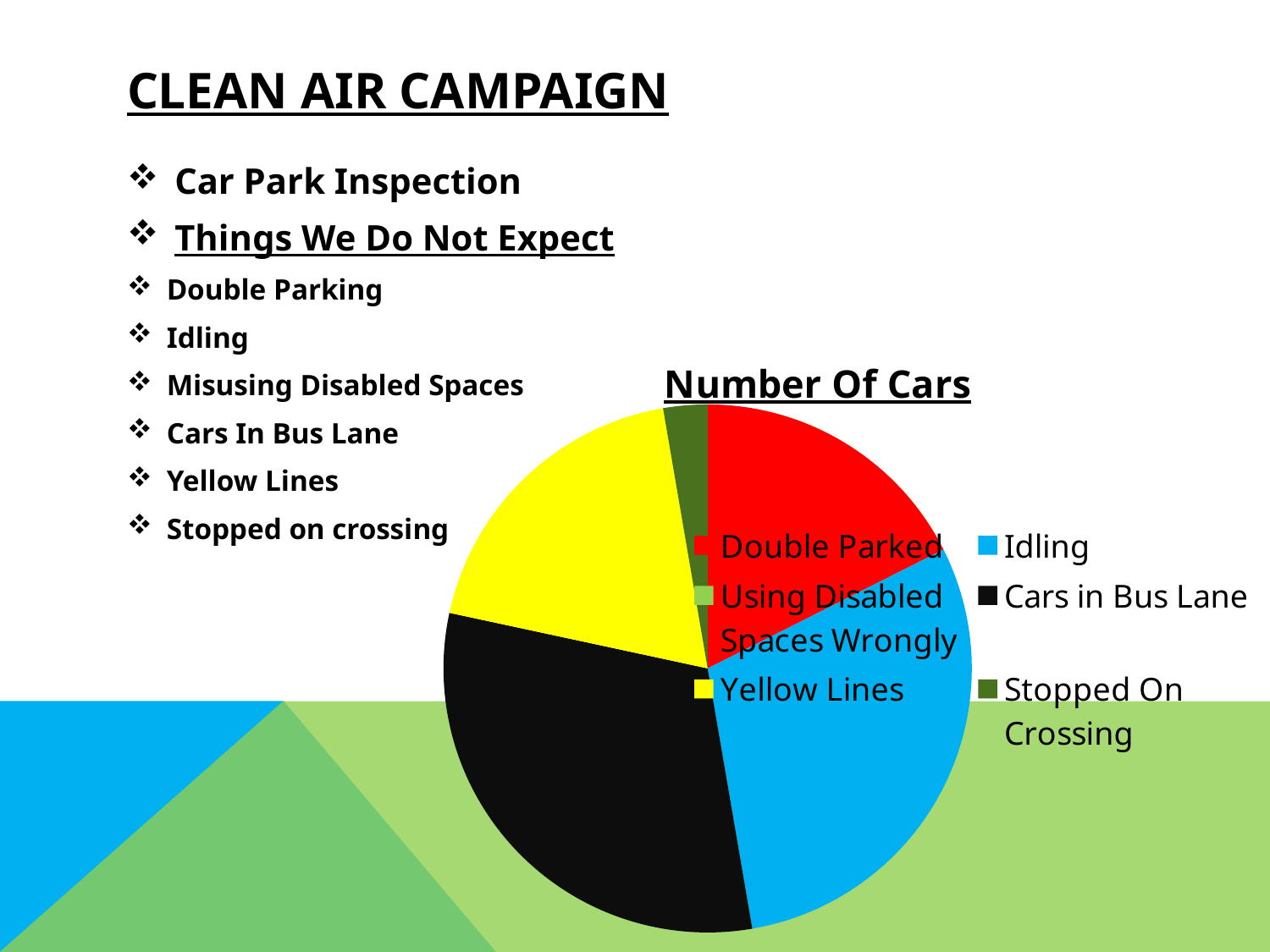
Which is larger in the pie chart, the slice for Yellow Lines or the slice for Stopped On Crossing? Yellow Lines What is the title of the chart? Number Of Cars Which is larger in the pie chart, the slice for Idling or the slice for Double Parked? Idling Which colour represents Idling in the pie chart? blue What kind of chart is shown on the slide? pie chart Which is larger in the pie chart, the slice for Cars in Bus Lane or the slice for Double Parked? Cars in Bus Lane How many entries does the chart's legend list? 6